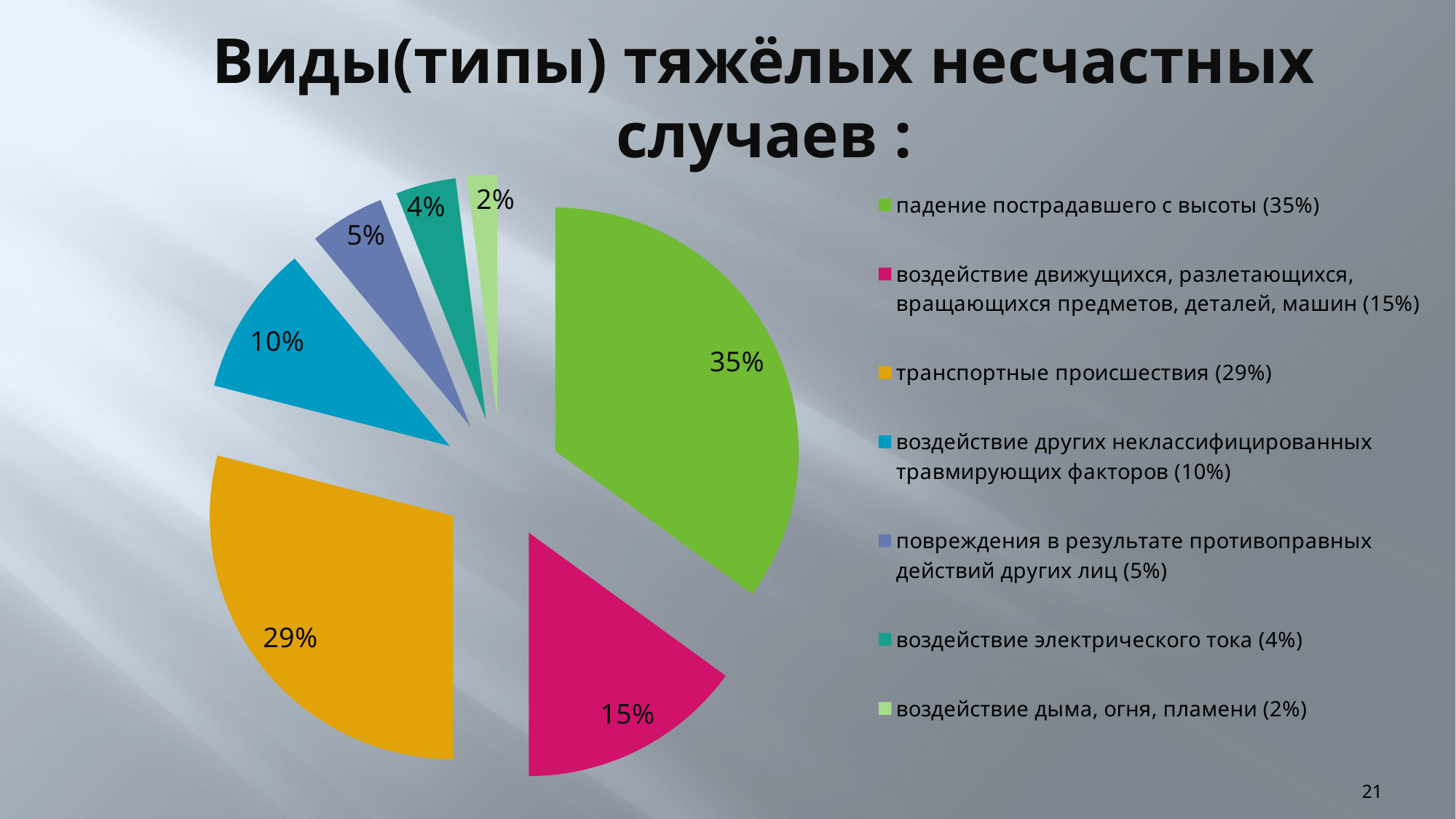
Which category has the smallest slice of the pie? воздействие дыма, огня, пламени Which category has the largest slice of the pie? падение пострадавшего с высоты What is the combined share of "воздействие электрического тока" and "воздействие дыма, огня, пламени"? 6% What kind of chart is shown on the slide? pie chart What is the value for "воздействие электрического тока"? 4% What share of the pie is "падение пострадавшего с высоты"? 35% What is the value for "транспортные происшествия"? 29% Which is larger: the share for "воздействие других неклассифицированных травмирующих факторов" or for "повреждения в результате противоправных действий других лиц"? воздействие других неклассифицированных травмирующих факторов What is the value for "воздействие дыма, огня, пламени"? 2% How many slices does the pie chart have? 7 What colour is the slice for "транспортные происшествия"? yellow/orange What is the difference between the shares of "падение пострадавшего с высоты" and "транспортные происшествия"? 6%